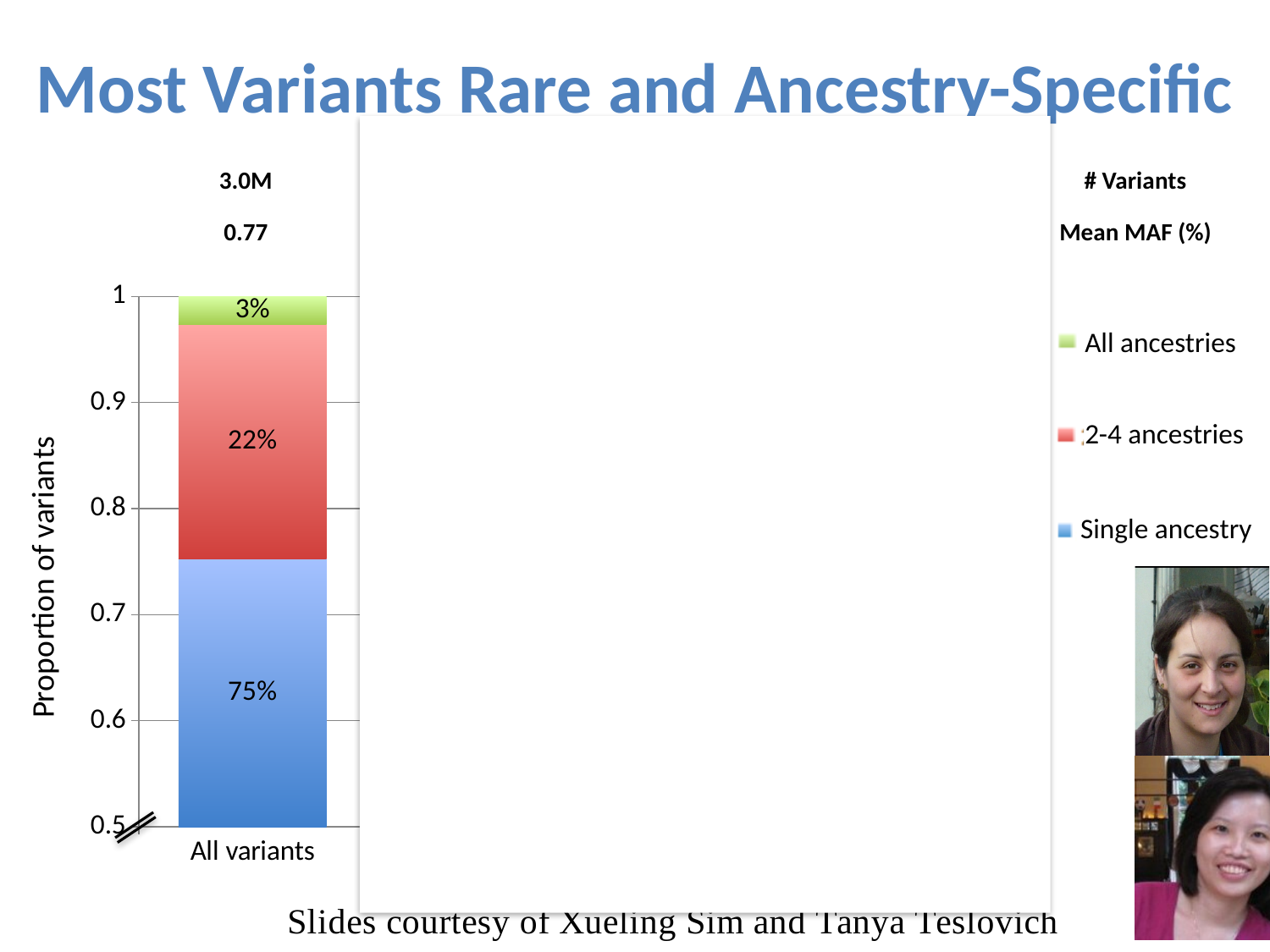
What is the number of variants (# Variants) shown above the 'All variants' bar? 3.0M What percentage of all variants are found in 2-4 ancestries? 22% Which segment of the 'All variants' bar is the largest? Single ancestry What is the label of the y axis? Proportion of variants What percentage of all variants are found in all ancestries? 3% What kind of chart is shown on the slide? stacked bar chart Which is larger: the 2-4 ancestries share or the All ancestries share? 2-4 ancestries What is the difference between the Single ancestry share and the 2-4 ancestries share? 53% Which segment of the 'All variants' bar is the smallest? All ancestries What percentage of all variants are found in a single ancestry? 75% How many series does the legend list? 3 What is the Mean MAF (%) shown above the 'All variants' bar? 0.77